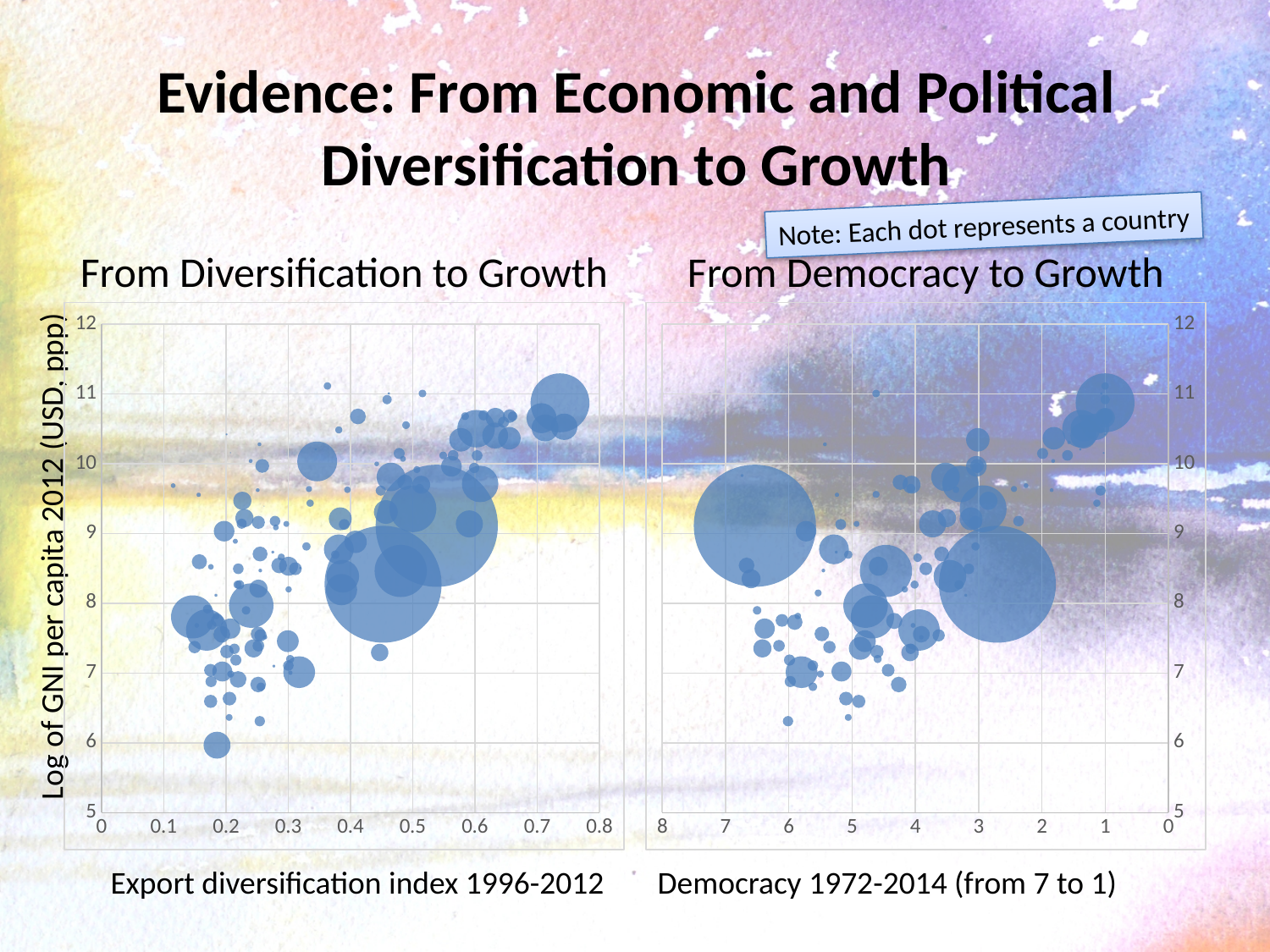
What is the y-axis label shared by the two charts? Log of GNI per capita 2012 (USD, ppp) In the 'From Diversification to Growth' chart, is the highest-placed bubble greater or less than 10 on the y axis? greater What is the x-axis label of the 'From Democracy to Growth' chart? Democracy 1972-2014 (from 7 to 1) In the 'From Diversification to Growth' chart, is the largest bubble above or below 9 on the y axis? below In the 'From Democracy to Growth' chart, do the values generally rise or fall moving from left to right along the x axis? rise How many charts are shown on the slide? 2 What kind of chart is 'From Diversification to Growth'? bubble chart In the 'From Diversification to Growth' chart, do the values generally rise or fall as the export diversification index increases along the x axis? rise